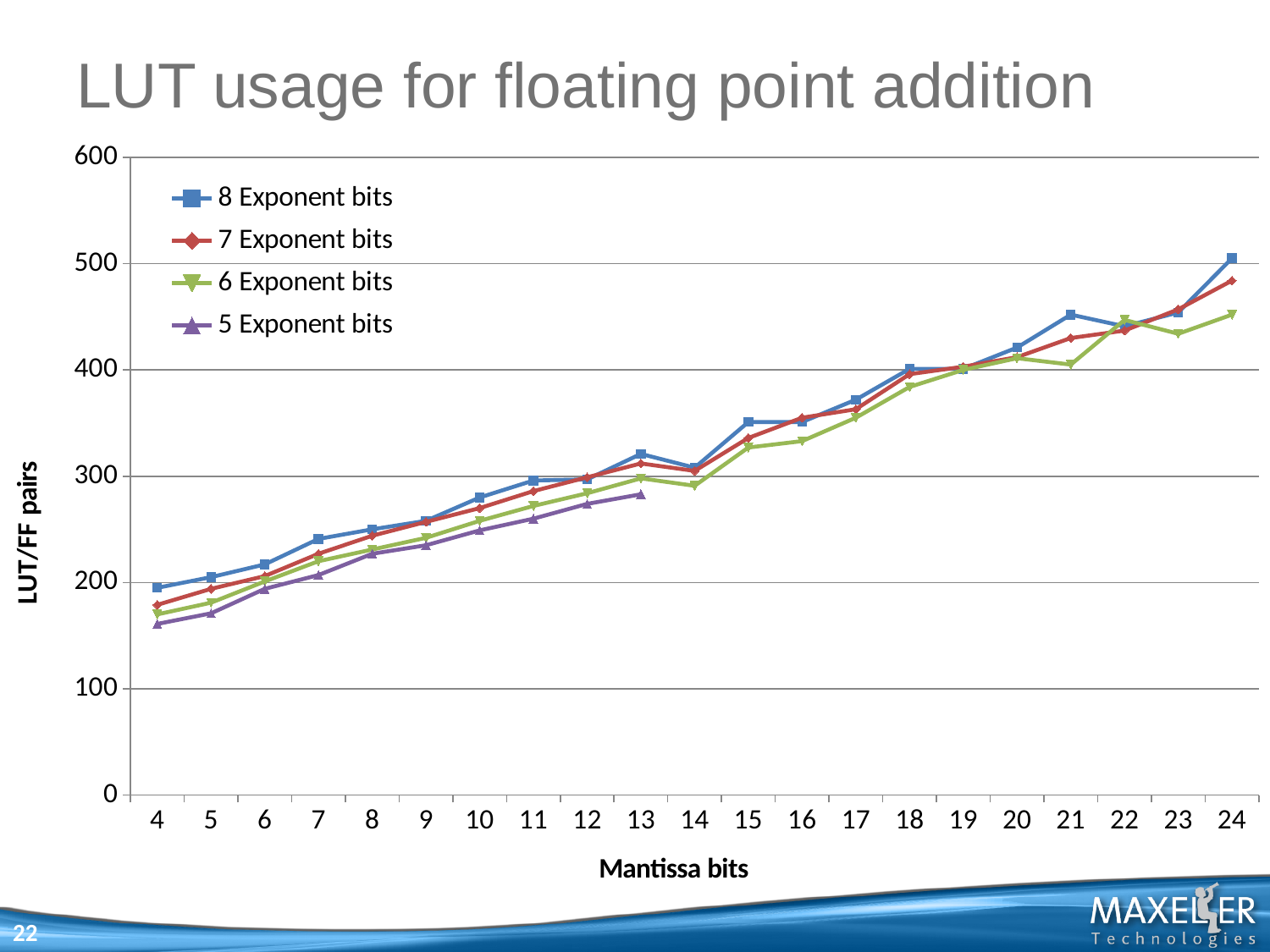
What kind of chart is shown on the slide? line chart At 4 mantissa bits, which series has the lowest LUT/FF pairs value? 5 Exponent bits How many mantissa bit values are shown on the x axis? 21 Is the value for 7 Exponent bits at 24 mantissa bits greater or less than 500? less At 24 mantissa bits, which is larger: the value for 8 Exponent bits or for 6 Exponent bits? 8 Exponent bits At 4 mantissa bits, which series has the highest LUT/FF pairs value? 8 Exponent bits Is the value for 8 Exponent bits at 15 mantissa bits greater or less than 300? greater What is the title of the y axis? LUT/FF pairs How many series does the legend list? 4 Do the LUT/FF pair values rise or fall as the number of mantissa bits increases? rise Is the value for 5 Exponent bits at 4 mantissa bits greater or less than 200? less